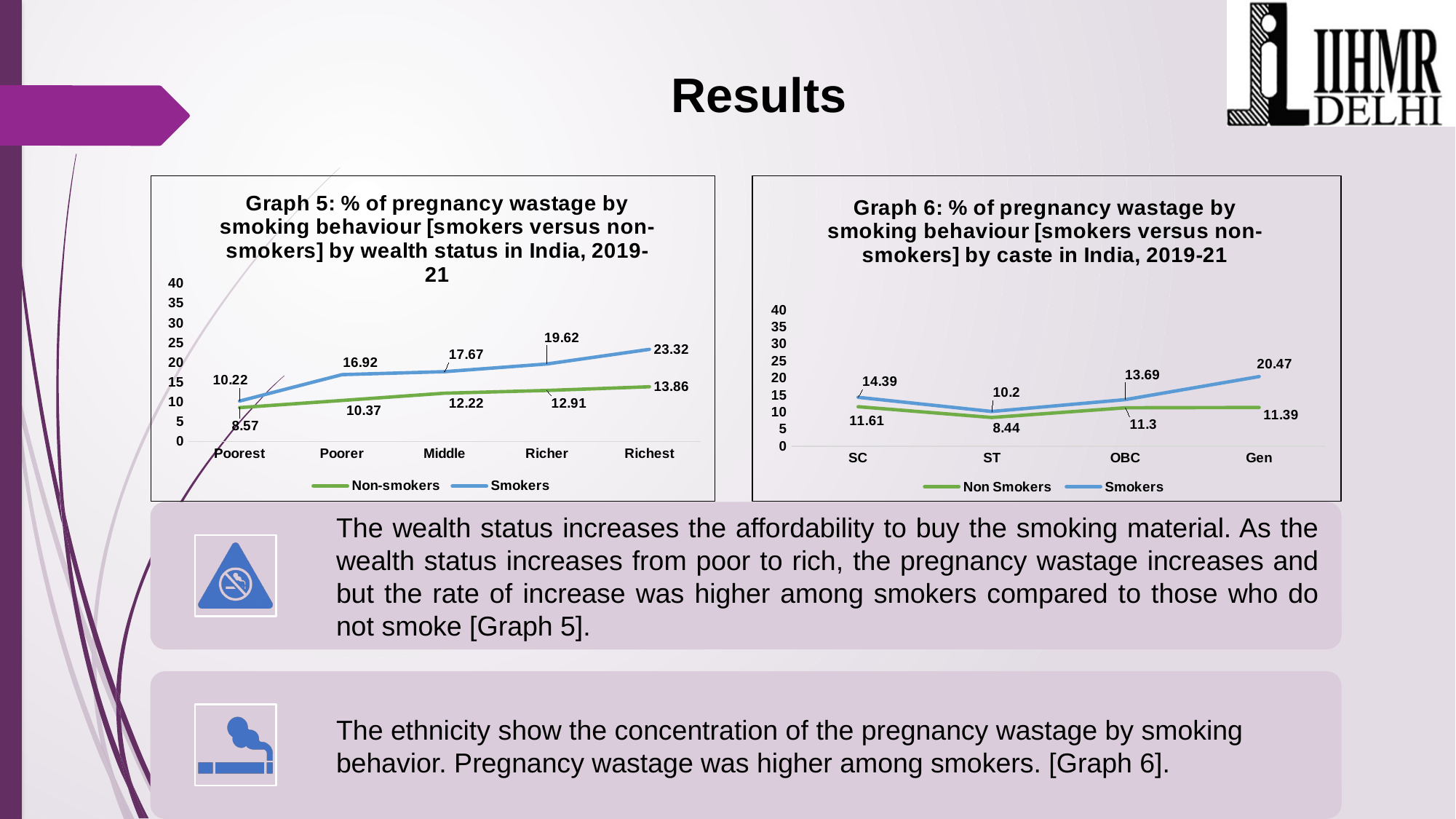
In Graph 5, do the Smokers values rise or fall from Poorest to Richest? rise In Graph 6, how many series does the legend list? 2 In Graph 6, which caste category has the lowest value for Smokers? ST In Graph 5, how many wealth categories are shown on the x axis? 5 In Graph 6, which is larger, the Smokers value for Gen or the Smokers value for SC? Gen What type of chart is Graph 6? line chart In Graph 5, what is the difference between the Smokers and Non-smokers values in the Richer category? 6.71 In Graph 5, which wealth category has the highest value for Smokers? Richest In Graph 5, what is the value for Non-smokers in the Poorest category? 8.57 In Graph 6, what is the value for Non Smokers in the ST category? 8.44 In Graph 5, what is the value for Smokers in the Richest category? 23.32 In Graph 6, what is the value for Smokers in the OBC category? 13.69